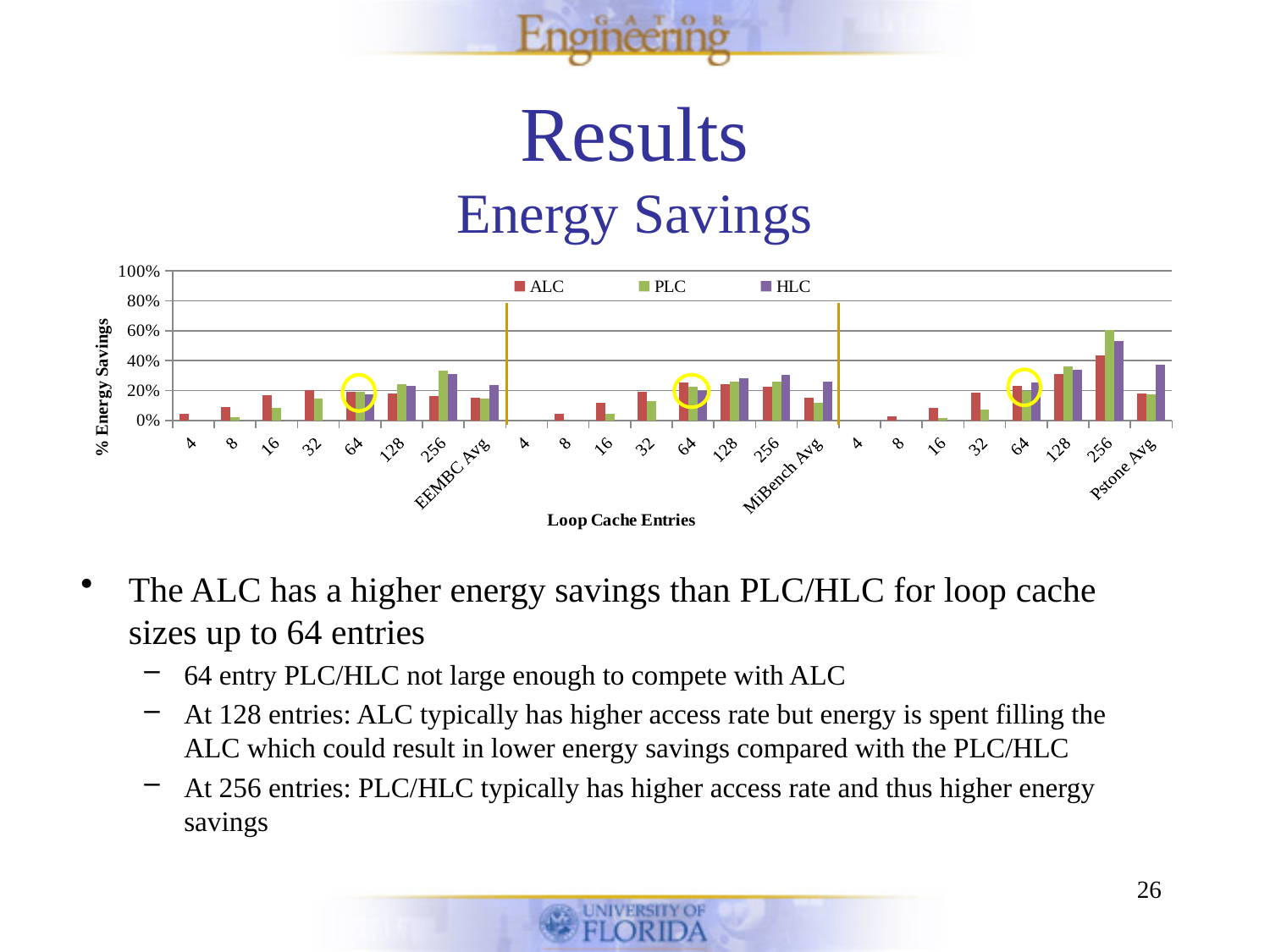
How many series does the chart legend list? 3 Is the HLC value for 256 entries in the Pstone group greater or less than 40%? greater Is the PLC value for 256 entries in the Pstone group greater or less than 40%? greater How many categories are shown along the x axis of the chart? 24 What kind of chart is shown on the slide? bar chart Is the ALC value for 4 entries in the EEMBC group greater or less than 20%? less At 64 entries in the EEMBC group, which is larger, the ALC value or the HLC value? ALC Which bar in the chart is the highest overall? PLC at 256 entries in the Pstone group What are the series names listed in the chart legend? ALC, PLC, HLC What is the title of the chart's x axis? Loop Cache Entries In the Pstone group, do the PLC values rise or fall from 64 entries to 256 entries? rise